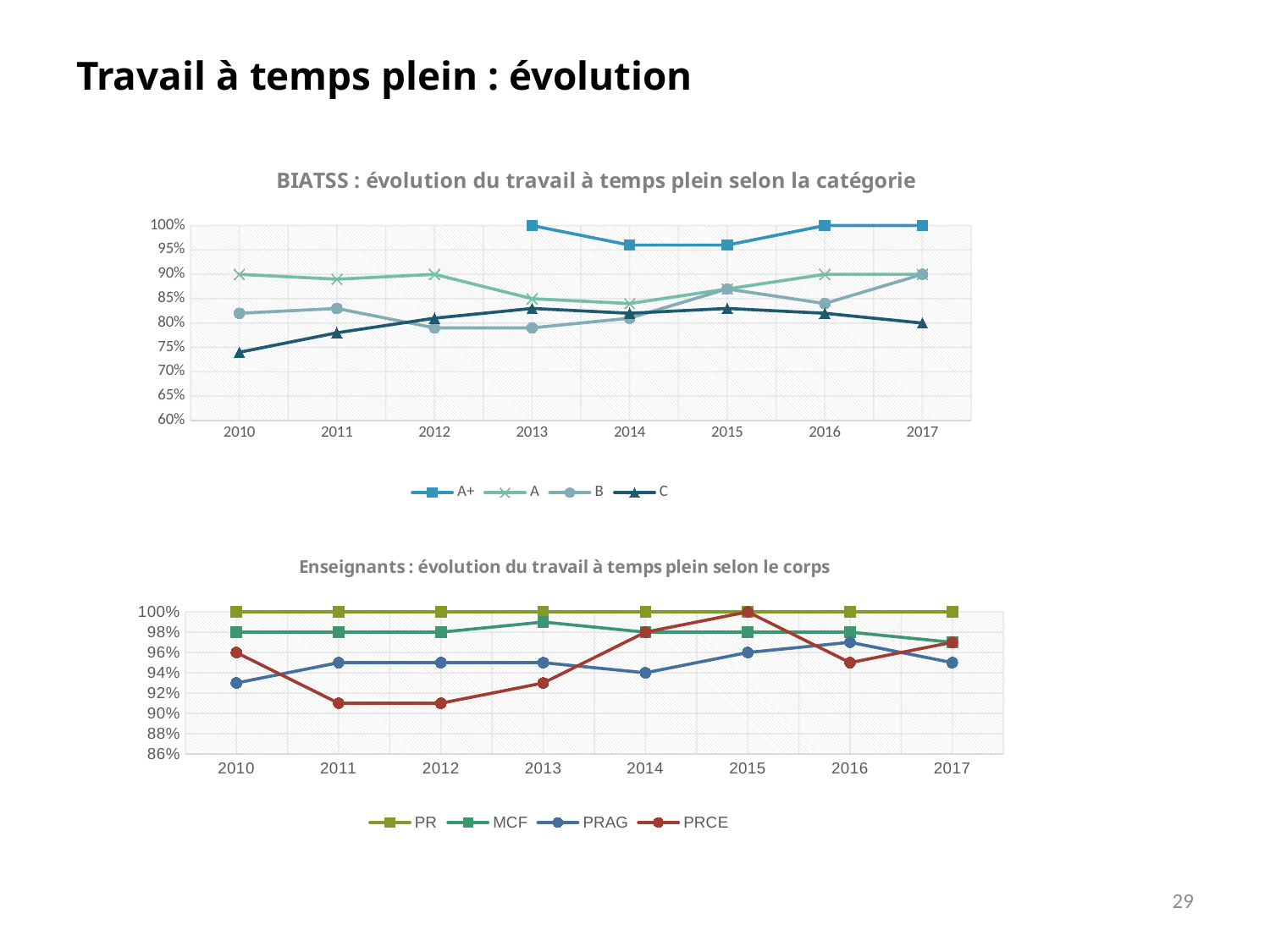
In the top chart (BIATSS), which category has the lowest value in 2010? C In the top chart (BIATSS), what is the value for A+ in 2013? 100% In the bottom chart (Enseignants), what is the value for PR in 2017? 100% In the top chart (BIATSS), what is the value for A in 2010? 90% In the bottom chart (Enseignants), does the PRCE line rise or fall from 2010 to 2011? fall In the bottom chart (Enseignants), is the value for PRCE in 2011 greater or less than 94%? less In the bottom chart (Enseignants), how many years are shown on the x axis? 8 What type of chart is the top chart titled "BIATSS : évolution du travail à temps plein selon la catégorie"? line chart In the top chart (BIATSS), is the value for C in 2010 greater or less than 80%? less In the top chart (BIATSS), which is larger in 2010, A or B? A In the top chart (BIATSS), how many series does the legend list? 4 In the bottom chart (Enseignants), what is the value for PRAG in 2014? 94%